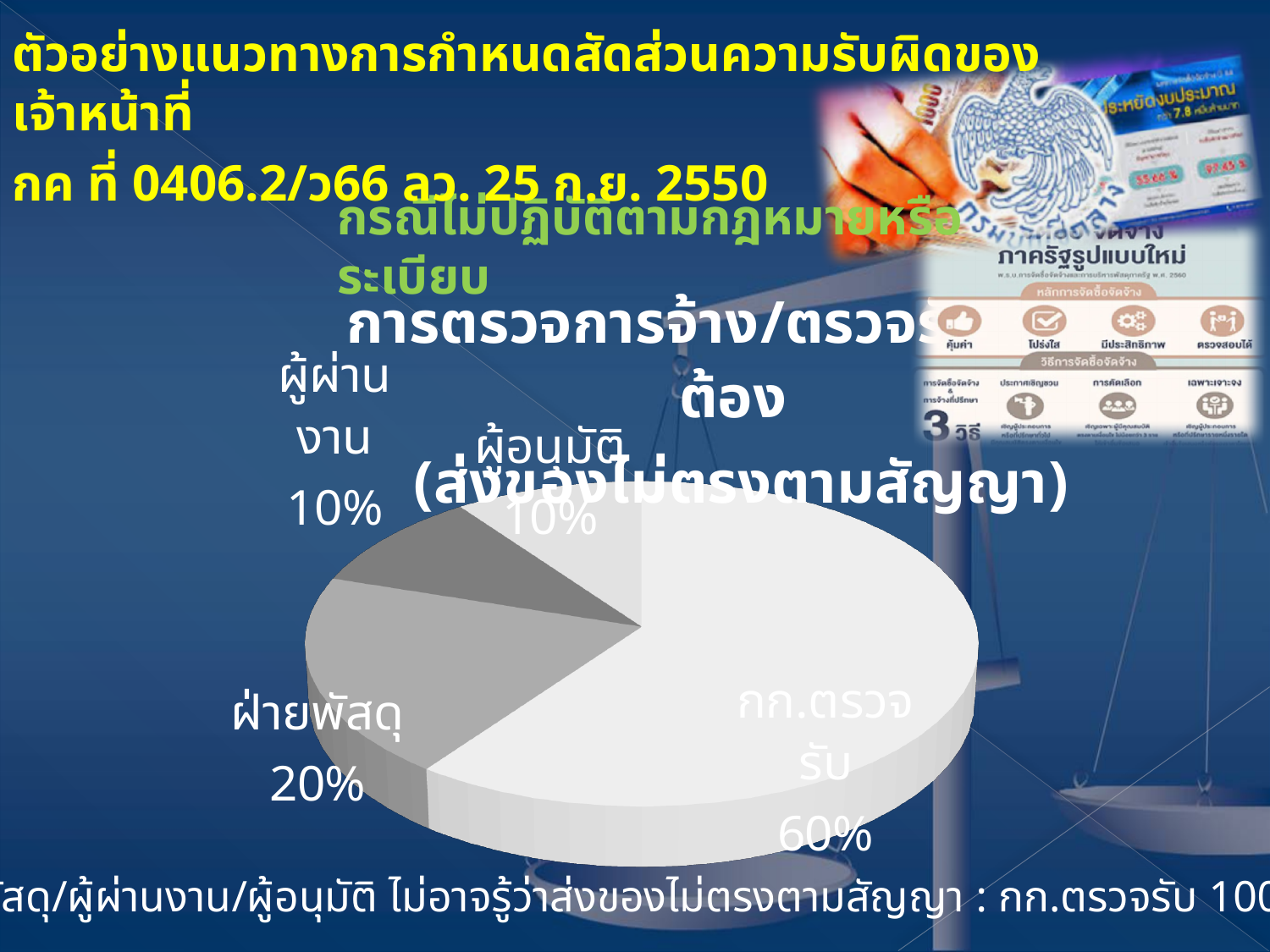
How many slices does the pie chart have? 4 What share of the pie does ฝ่ายพัสดุ hold? 20% Is the share of กก.ตรวจรับ greater or less than 50%? greater What share of the pie does กก.ตรวจรับ hold? 60% Which is larger, the share of ฝ่ายพัสดุ or the share of ผู้ผ่านงาน? ฝ่ายพัสดุ What is the combined share of ผู้ผ่านงาน and ผู้อนุมัติ? 20% What is the difference between the shares of กก.ตรวจรับ and ฝ่ายพัสดุ? 40% What share of the pie does ผู้อนุมัติ hold? 10% What share of the pie does ผู้ผ่านงาน hold? 10% Which category has the largest slice of the pie? กก.ตรวจรับ What kind of chart is shown on the slide? pie chart What is the difference between the shares of ฝ่ายพัสดุ and ผู้อนุมัติ? 10%